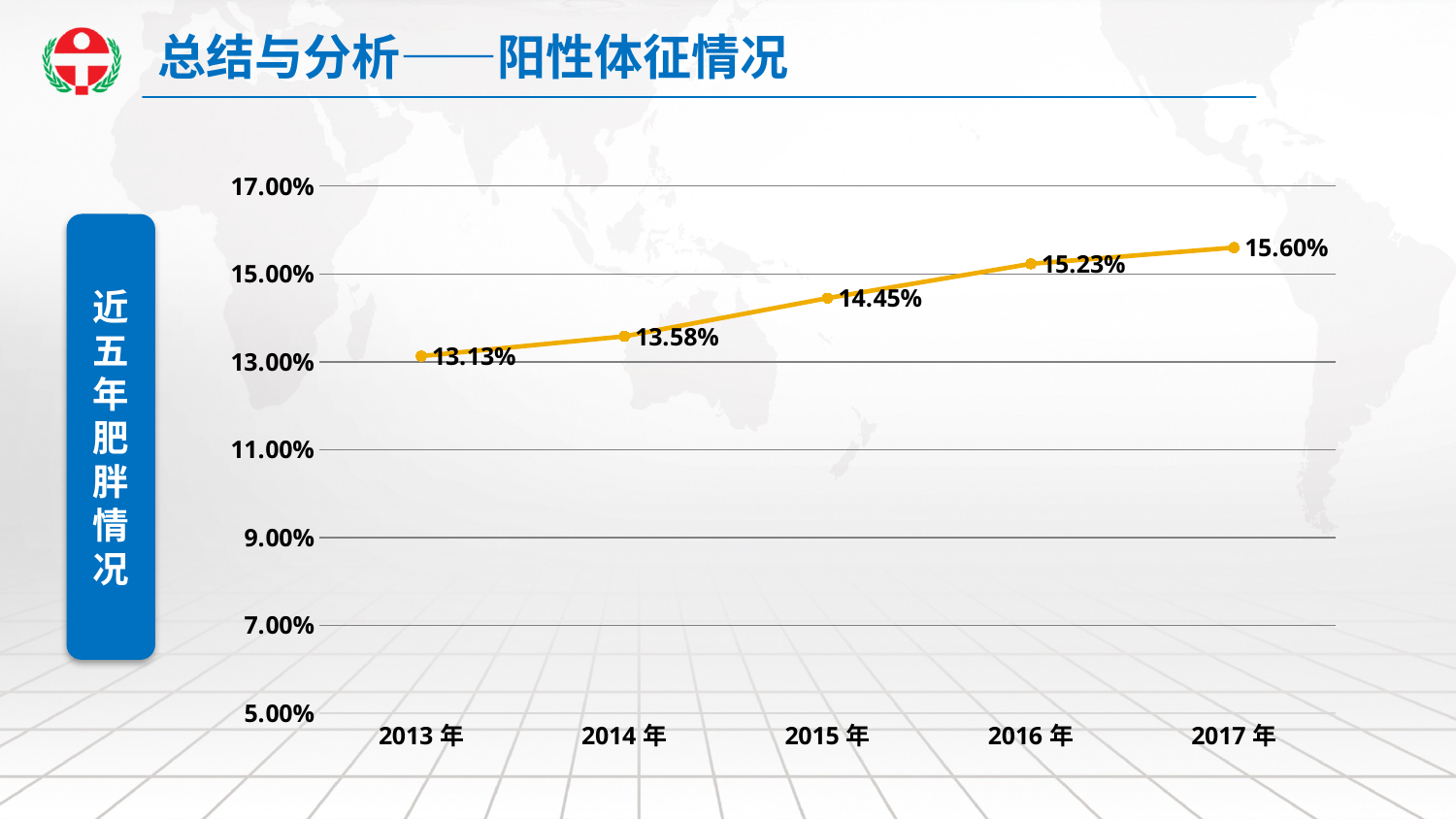
What is the value for 2016 年? 15.23% Do the values rise or fall from 2013 年 to 2017 年? rise Which year has the highest value? 2017 年 What is the value for 2013 年? 13.13% What is the value for 2015 年? 14.45% How many years are plotted on the chart? 5 What is the difference between the values for 2015 年 and 2014 年? 0.87% What kind of chart is shown on the slide? line chart What is the value for 2017 年? 15.60% Which is larger, the value for 2014 年 or the value for 2016 年? 2016 年 What is the difference between the values for 2017 年 and 2013 年? 2.47% Which year has the lowest value? 2013 年